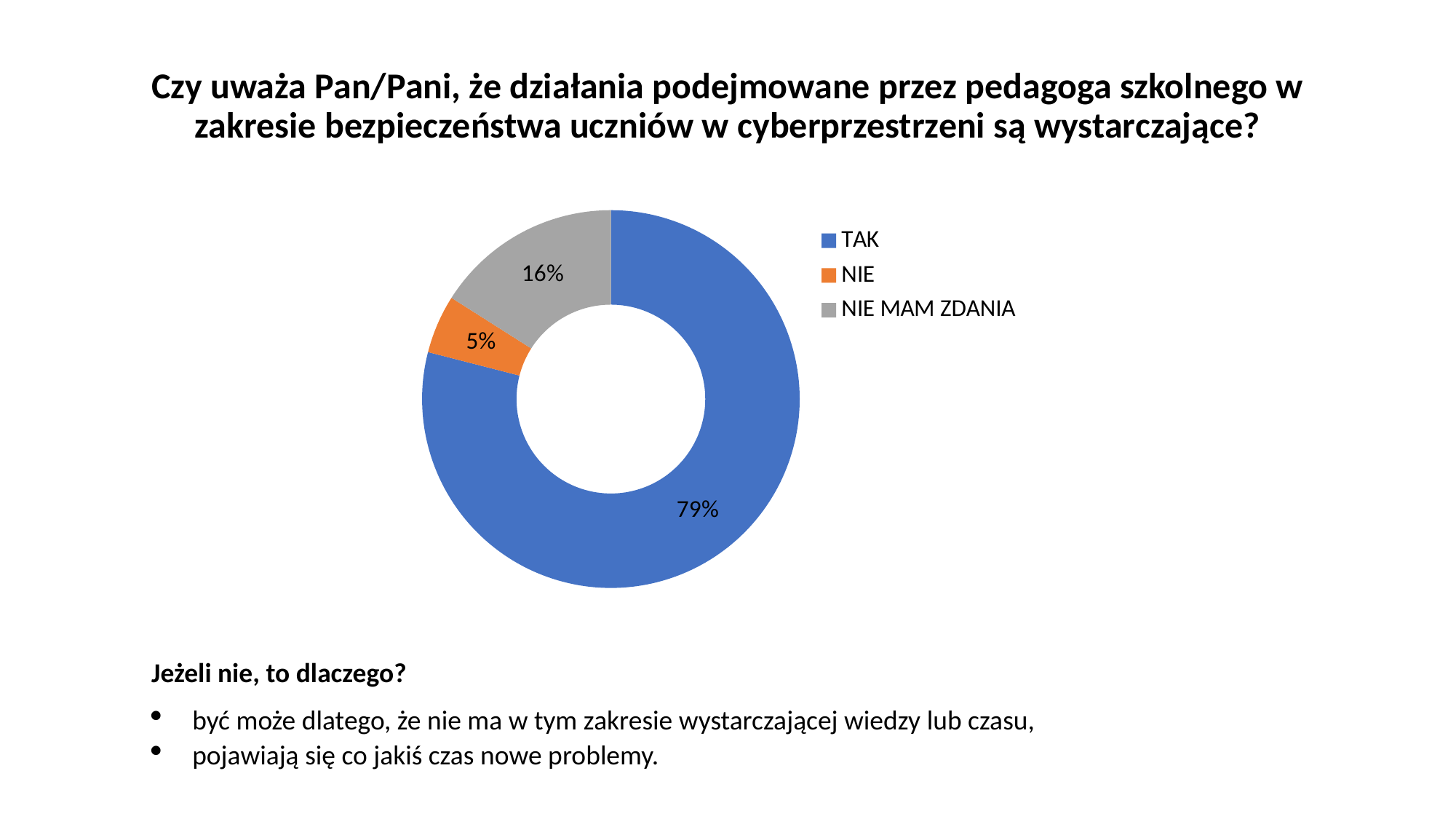
What percentage of respondents answered NIE? 5% What kind of chart is shown on the slide? Doughnut (pie) chart What is the difference in percentage points between NIE MAM ZDANIA and NIE? 11 What colour represents the NIE category in the chart? Orange What colour represents the TAK category in the chart? Blue How many categories does the chart show? 3 What percentage of respondents answered TAK? 79% Which answer has the largest share of the chart? TAK What is the difference in percentage points between TAK and NIE MAM ZDANIA? 63 Which answer has the smallest share of the chart? NIE Which is larger, the share for NIE or the share for NIE MAM ZDANIA? NIE MAM ZDANIA What percentage of respondents answered NIE MAM ZDANIA? 16%